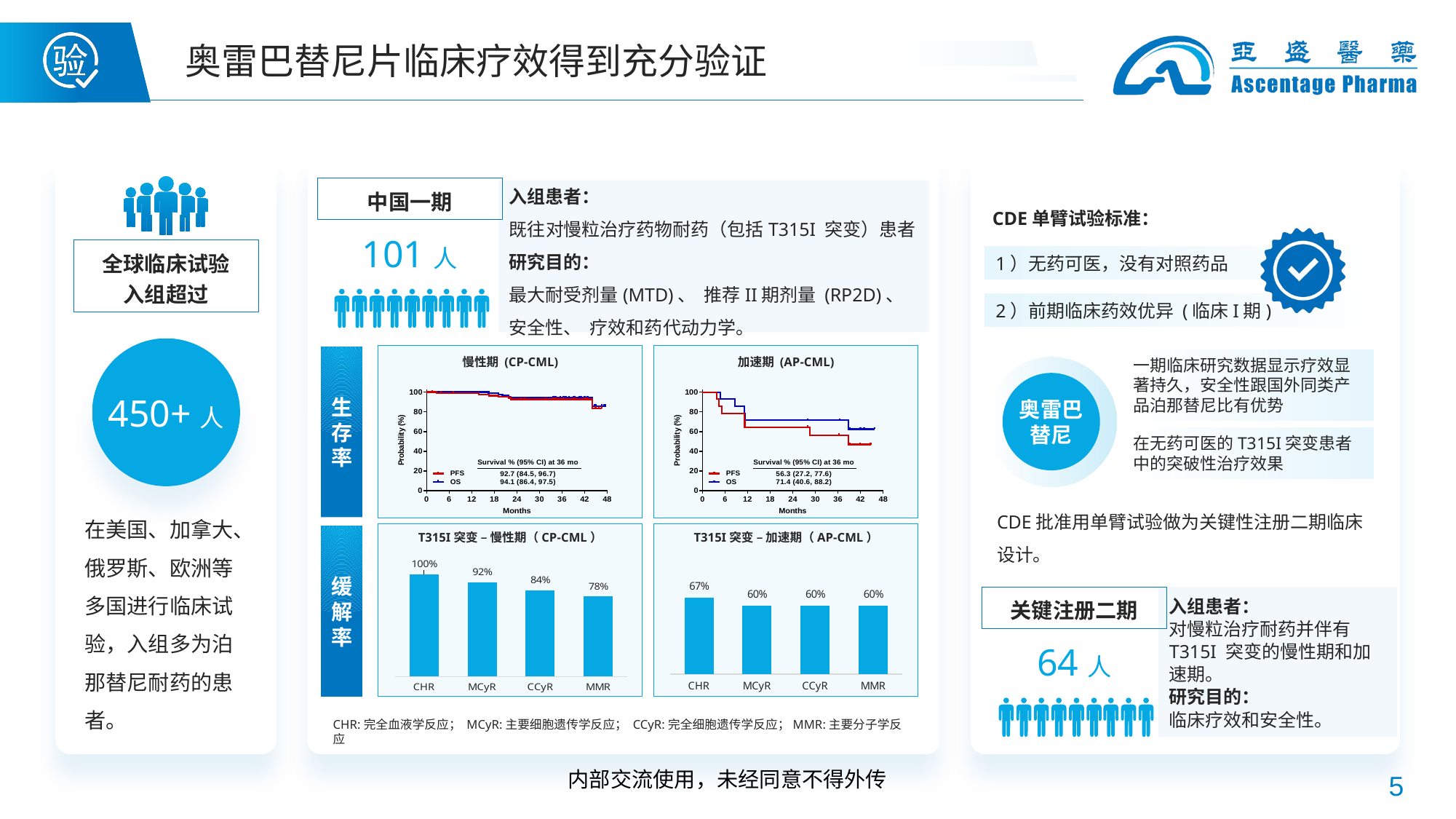
Which is larger: the CCyR value in the CP-CML bar chart or the CCyR value in the AP-CML bar chart? CP-CML In the bar chart titled 'T315I 突变 – 加速期（AP-CML）', what is the value for CHR? 67% In the bar chart titled 'T315I 突变 – 慢性期（CP-CML）', which category has the lowest value? MMR In the bar chart titled 'T315I 突变 – 加速期（AP-CML）', how many categories are shown? 4 What kind of chart is the 'T315I 突变 – 加速期（AP-CML）' chart? bar chart In the survival chart titled '慢性期 (CP-CML)', what is the OS survival % at 36 months? 94.1 (86.4, 97.5) In the bar chart titled 'T315I 突变 – 慢性期（CP-CML）', what is the value for MMR? 78% In the bar chart titled 'T315I 突变 – 加速期（AP-CML）', which category has the highest value? CHR In the bar chart titled 'T315I 突变 – 慢性期（CP-CML）', do the values rise or fall from CHR to MMR? fall In the bar chart titled 'T315I 突变 – 慢性期（CP-CML）', what is the value for CHR? 100% In the bar chart titled 'T315I 突变 – 慢性期（CP-CML）', what is the difference between the MCyR and CCyR values? 8% How many series does the legend of the '加速期 (AP-CML)' survival chart list? 2